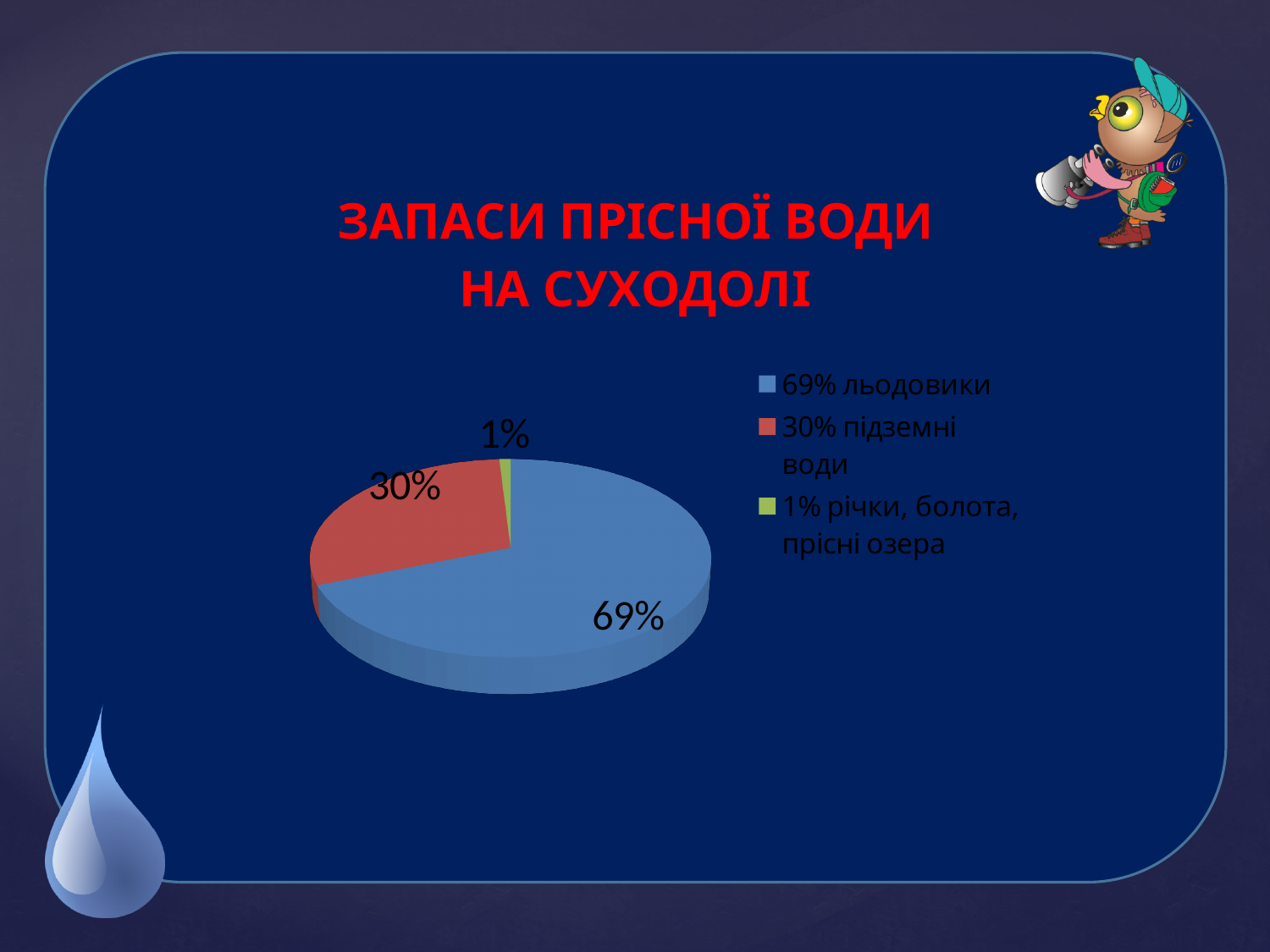
What is the difference in percentage points between the льодовики slice and the підземні води slice? 39 What share of the pie does the slice for льодовики (glaciers) take? 69% What kind of chart is shown on the slide? pie chart What share of the pie does the slice for підземні води (groundwater) take? 30% How many slices does the pie chart have? 3 Which category has the largest slice of the pie? льодовики What colour is the slice for льодовики in the pie chart? blue What is the title of the chart on the slide? ЗАПАСИ ПРІСНОЇ ВОДИ НА СУХОДОЛІ Which is larger: the slice for підземні води or the slice for річки, болота, прісні озера? підземні води Which category has the smallest slice of the pie? річки, болота, прісні озера What is the difference in percentage points between the підземні води slice and the річки, болота, прісні озера slice? 29 What share of the pie does the slice for річки, болота, прісні озера take? 1%